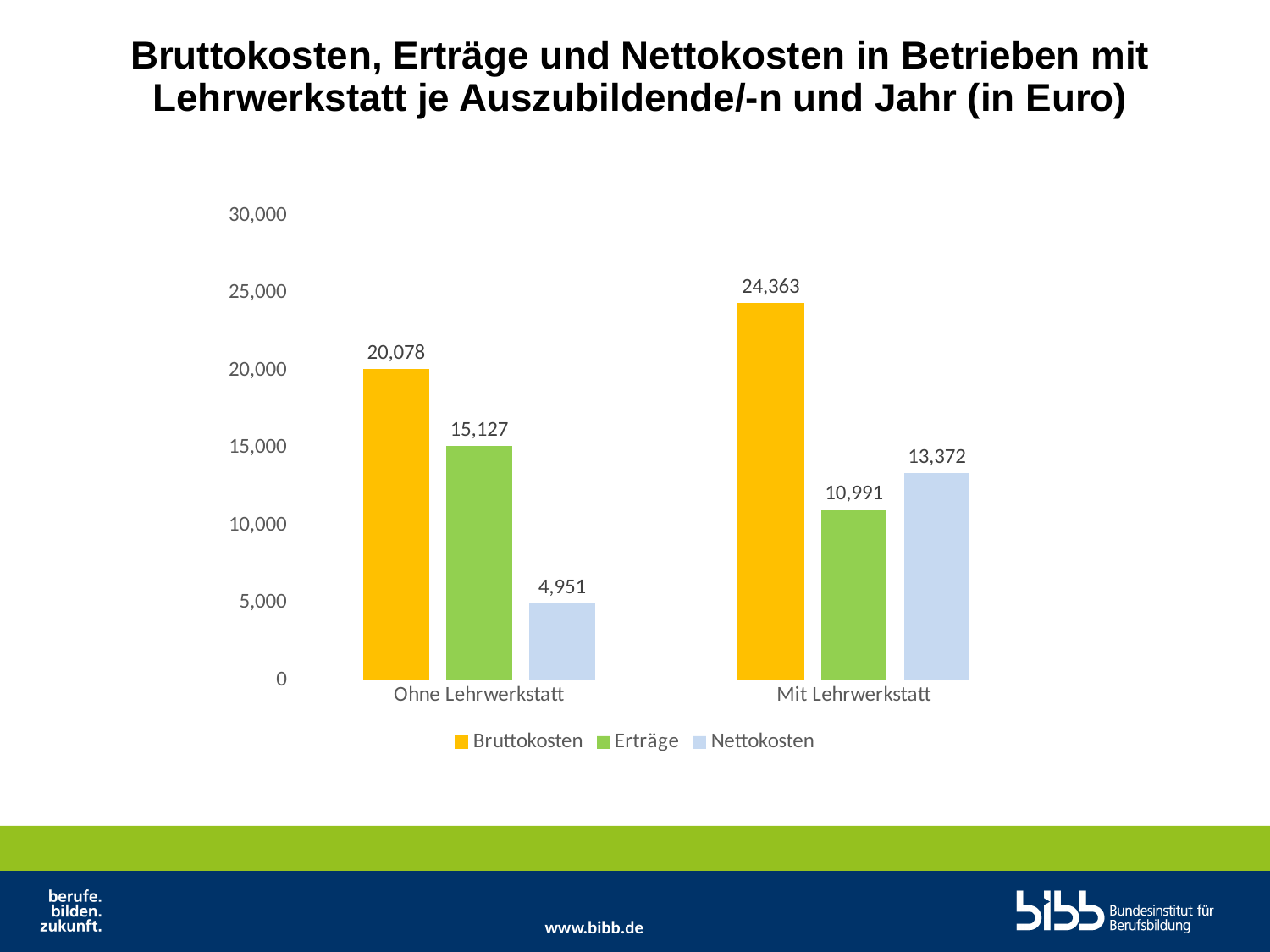
What is the difference between the Nettokosten for Mit Lehrwerkstatt and Ohne Lehrwerkstatt? 8,421 What is the Erträge value for Mit Lehrwerkstatt? 10,991 What kind of chart is shown on the slide? bar chart Which category has the lower Nettokosten? Ohne Lehrwerkstatt What is the Bruttokosten value for Ohne Lehrwerkstatt? 20,078 What is the Nettokosten value for Mit Lehrwerkstatt? 13,372 Which is larger: Erträge for Ohne Lehrwerkstatt or Erträge for Mit Lehrwerkstatt? Erträge for Ohne Lehrwerkstatt How many categories are shown on the x axis? 2 Which category has the higher Bruttokosten? Mit Lehrwerkstatt Is the Nettokosten value for Ohne Lehrwerkstatt greater or less than 5,000? less How many series does the legend list? 3 What is the difference between the Bruttokosten for Mit Lehrwerkstatt and Ohne Lehrwerkstatt? 4,285